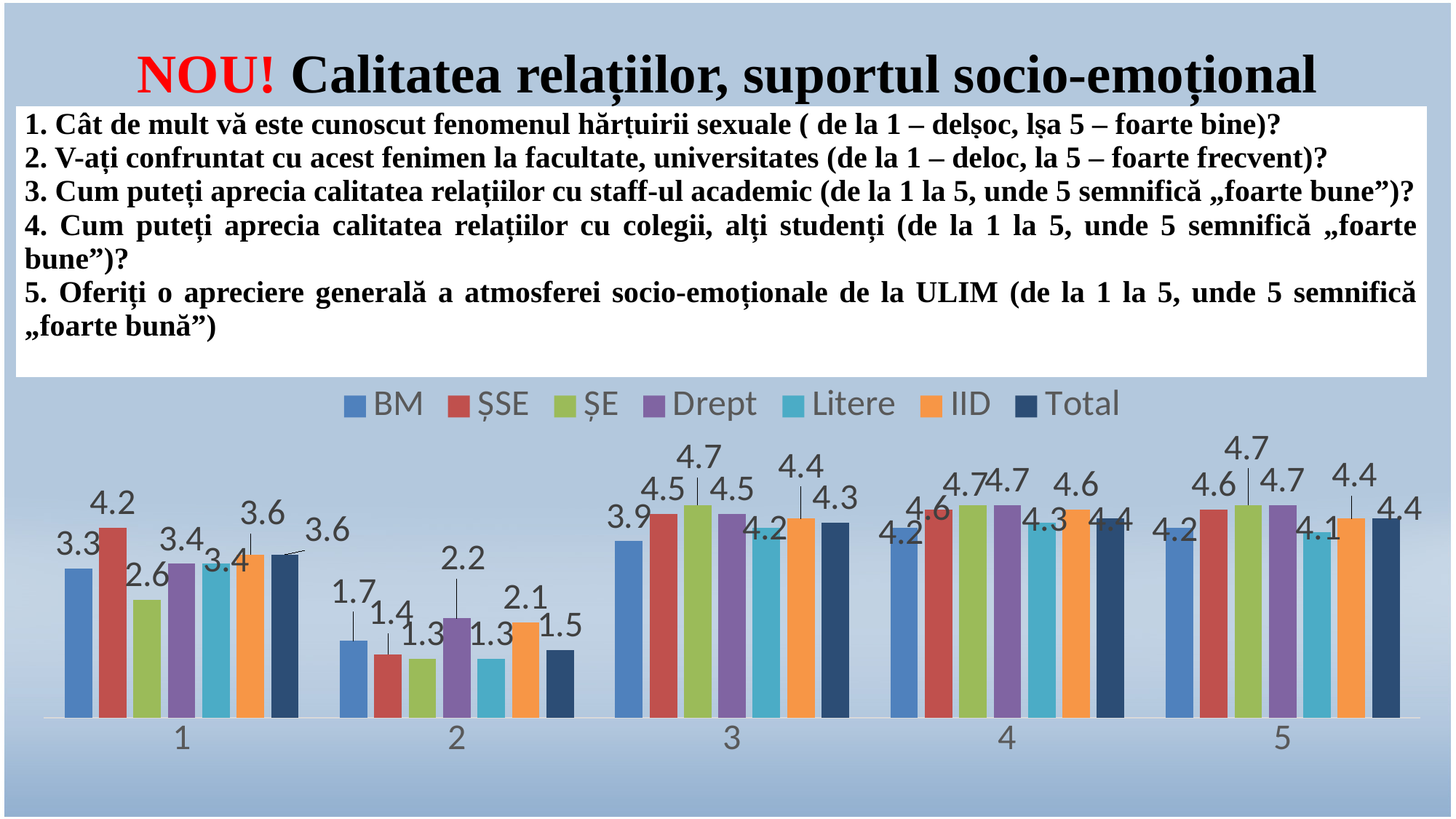
How many categories are shown on the x axis? 5 What is the value for Drept in category 2? 2.2 What is the value for BM in category 3? 3.9 What kind of chart is shown on the slide? bar chart What is the difference between the ȘSE and ȘE values in category 1? 1.6 Which series has the highest value in category 3? ȘE How many series does the legend list? 7 Which series has the lowest value in category 1? ȘE What is the value for Total in category 3? 4.3 What is the value for ȘSE in category 1? 4.2 Which is larger in category 2: the value for BM or the value for IID? IID Which series is shown in orange in the legend? IID